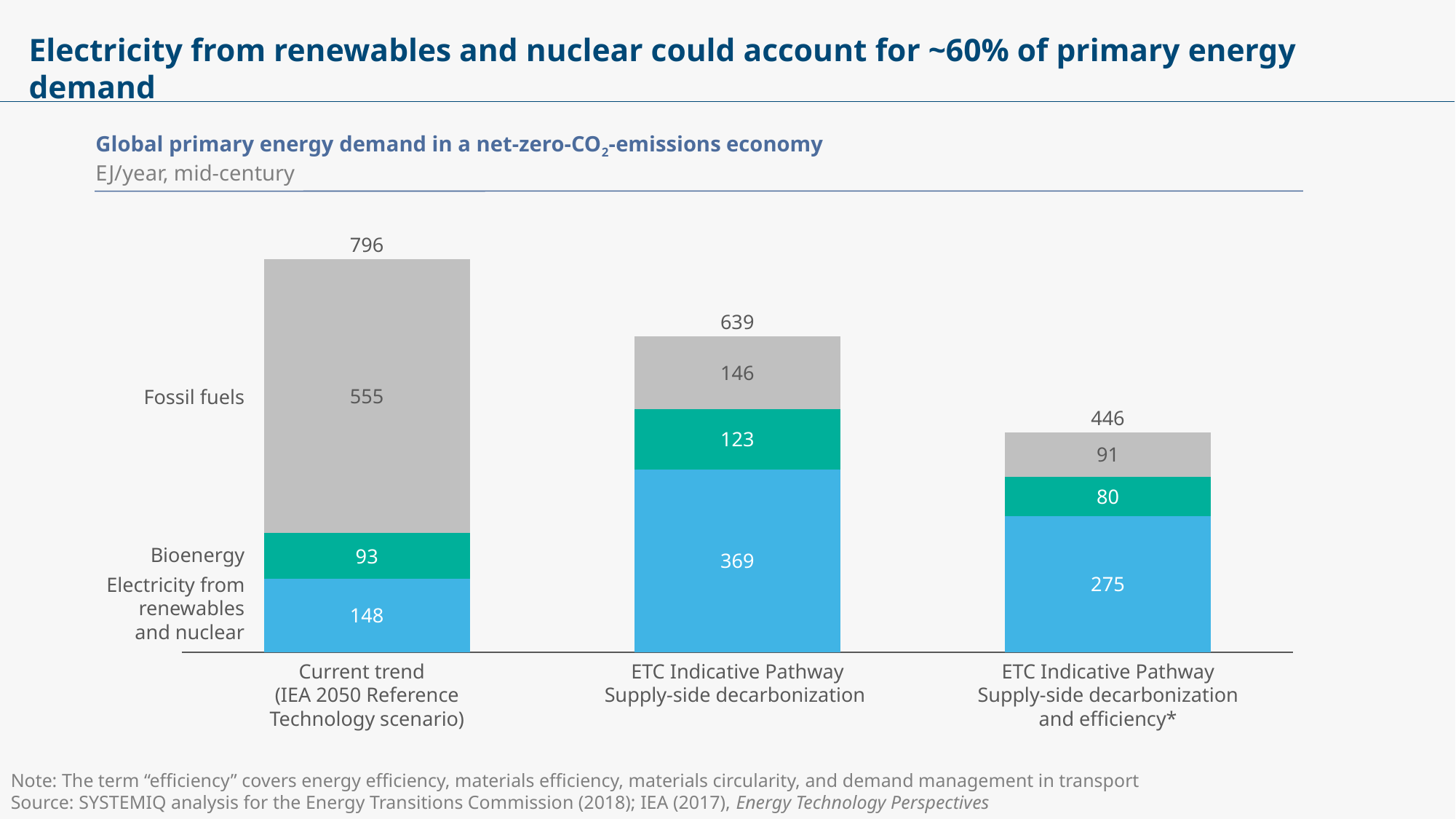
How many series are stacked in each bar? 3 What kind of chart is shown on the slide? Stacked bar chart What is the difference between the total of the Current trend bar and the total of the ETC Indicative Pathway Supply-side decarbonization and efficiency* bar? 350 How many scenarios (bars) are shown in the chart? 3 What is the total of the ETC Indicative Pathway Supply-side decarbonization stacked bar? 639 Which is larger: the Bioenergy value in the Current trend scenario or the Bioenergy value in the ETC Indicative Pathway Supply-side decarbonization scenario? ETC Indicative Pathway Supply-side decarbonization Which scenario has the highest total primary energy demand? Current trend (IEA 2050 Reference Technology scenario) Which scenario has the lowest Fossil fuels value? ETC Indicative Pathway Supply-side decarbonization and efficiency* What is the Bioenergy value for the ETC Indicative Pathway Supply-side decarbonization and efficiency* bar? 80 What is the Fossil fuels value for the Current trend (IEA 2050 Reference Technology scenario) bar? 555 What is the Electricity from renewables and nuclear value for the ETC Indicative Pathway Supply-side decarbonization bar? 369 What unit is the chart measured in, according to the subtitle? EJ/year